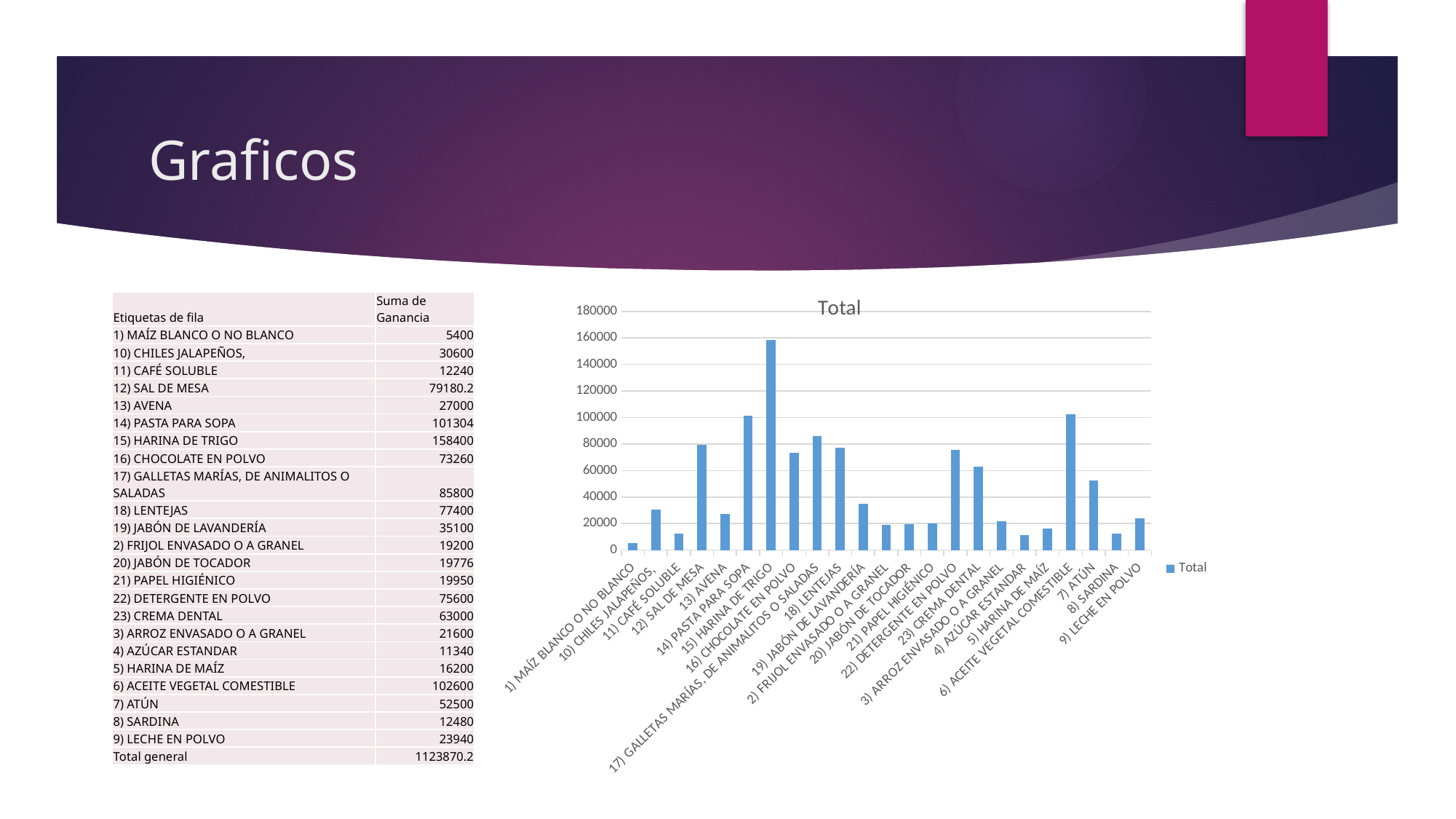
Which category has the highest bar in the chart? 15) HARINA DE TRIGO Is the value for 6) ACEITE VEGETAL COMESTIBLE greater or less than 100000? greater Is the value for 15) HARINA DE TRIGO greater or less than 140000? greater What is the title of the chart? Total What type of chart is shown on the slide? bar chart According to the table on the slide, what is the Total general of Suma de Ganancia? 1123870.2 How many series does the chart legend list? 1 How many categories are plotted on the chart? 23 Which category has the lowest bar in the chart? 1) MAÍZ BLANCO O NO BLANCO Is the value for 13) AVENA greater or less than 40000? less Which is larger, the value for 14) PASTA PARA SOPA or the value for 22) DETERGENTE EN POLVO? 14) PASTA PARA SOPA According to the table on the slide, what is the Suma de Ganancia for 7) ATÚN? 52500